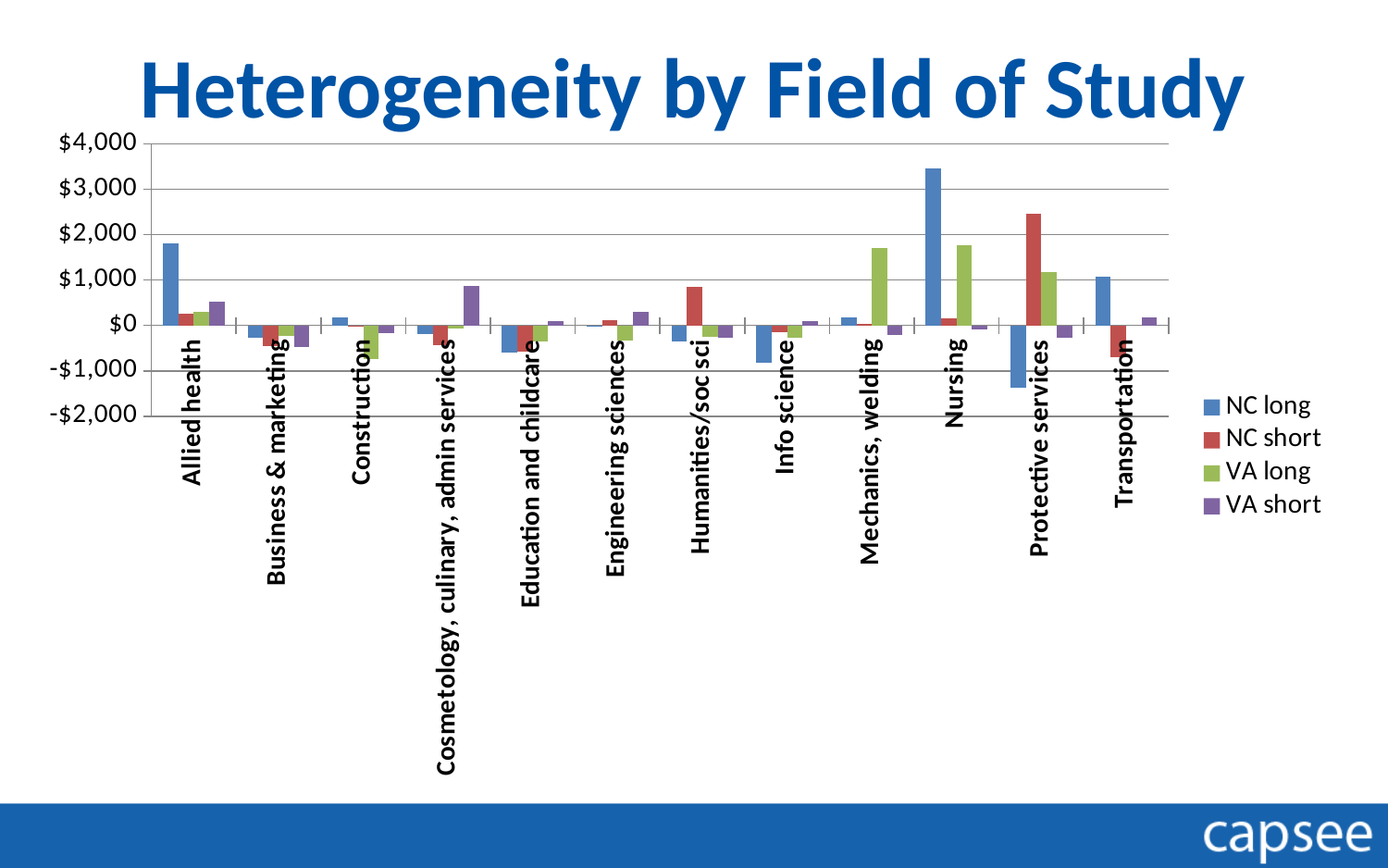
Which field of study has the highest NC short value? Protective services What is the title of the chart? Heterogeneity by Field of Study Is the NC short value for Protective services greater or less than $2,000? greater How many series does the legend list? 4 Which is larger: the NC long value for Nursing or the NC short value for Protective services? NC long value for Nursing Is the VA long value for Mechanics, welding greater or less than $1,000? greater Which field of study has the highest NC long value? Nursing Is the NC long value for Nursing greater or less than $3,000? greater Which field of study has the lowest NC long value? Protective services How many fields of study are shown on the x axis? 12 What kind of chart is shown on the slide? bar chart